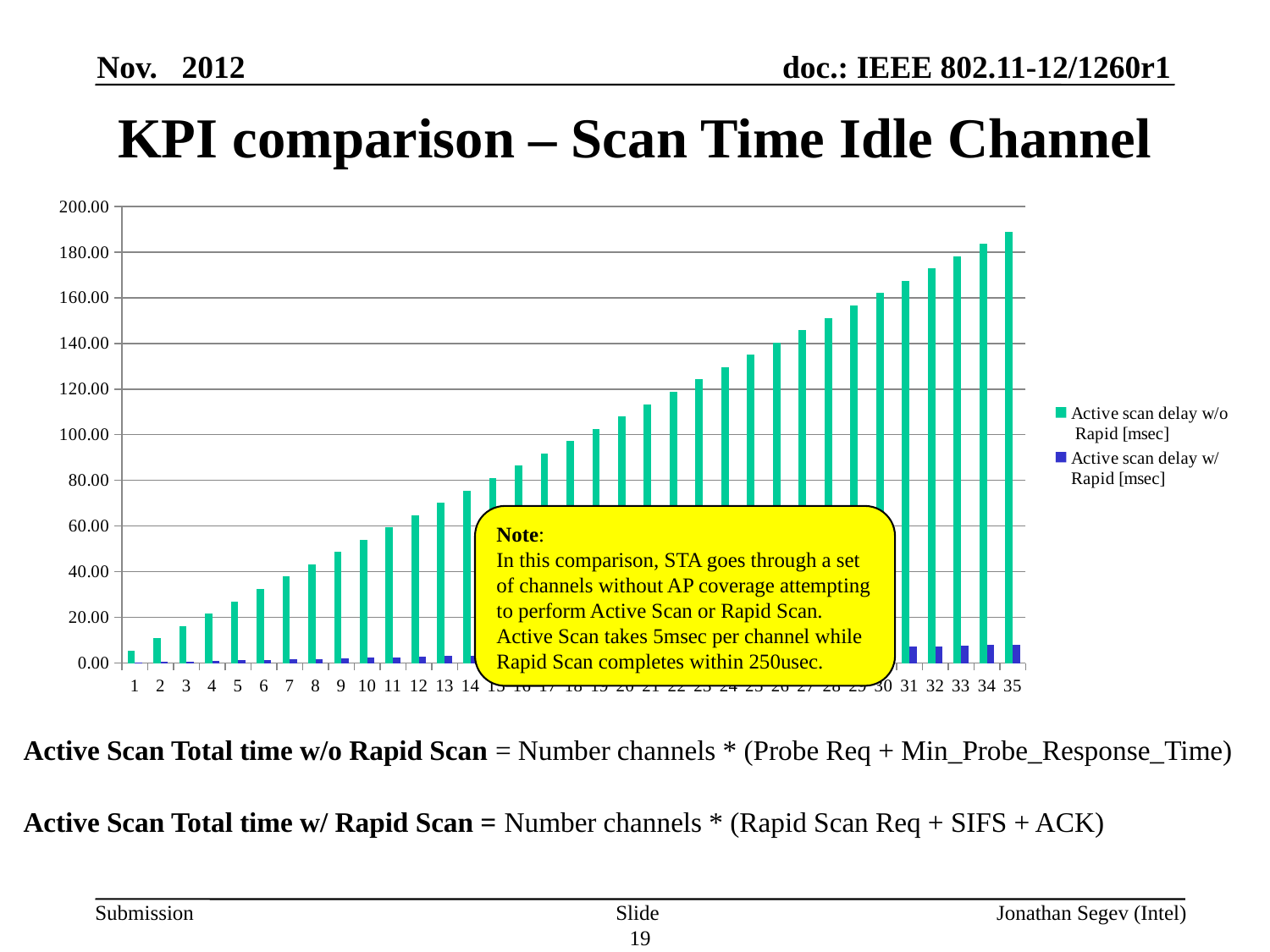
Is the value for category 1 in the Active scan delay w/o Rapid [msec] series greater or less than 20? less Which category has the lowest value for Active scan delay w/o Rapid [msec]? 1 Is the value for category 25 in the Active scan delay w/o Rapid [msec] series greater or less than 140? less At category 35, which series has the larger value: Active scan delay w/o Rapid [msec] or Active scan delay w/ Rapid [msec]? Active scan delay w/o Rapid [msec] Do the values for Active scan delay w/o Rapid [msec] rise or fall as the category number increases? rise Which series is drawn in green bars? Active scan delay w/o Rapid [msec] How many series does the legend list? 2 How many categories are shown along the x axis? 35 Is the value for category 20 in the Active scan delay w/o Rapid [msec] series greater or less than 100? greater Which category has the highest value for Active scan delay w/o Rapid [msec]? 35 What kind of chart is shown on the slide? bar chart